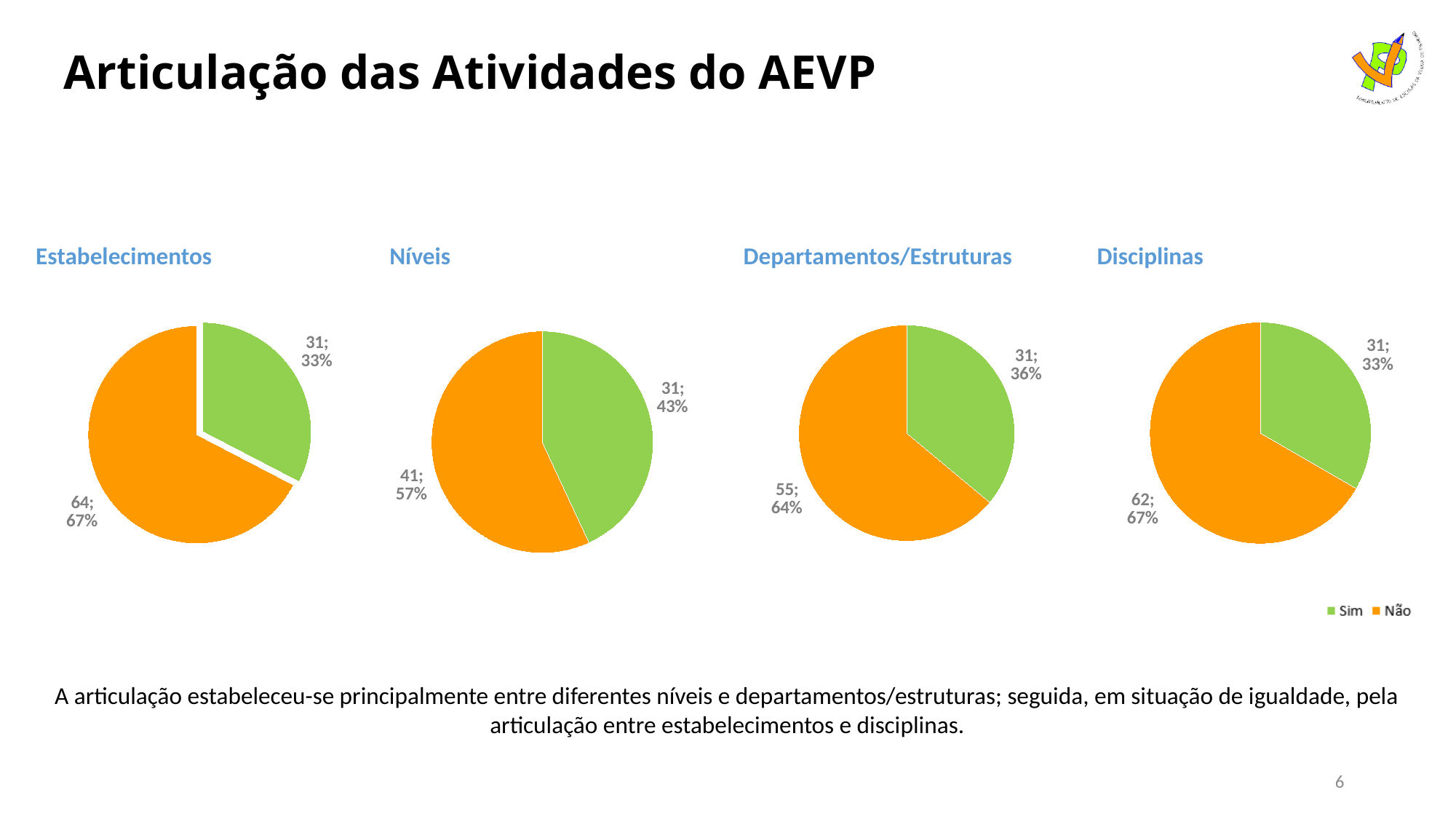
In the 'Estabelecimentos' chart, what share of the pie does 'Sim' represent? 33% In the 'Estabelecimentos' chart, what is the count for 'Não'? 64 In the 'Departamentos/Estruturas' chart, what share of the pie does 'Sim' represent? 36% In the 'Níveis' chart, what is the difference between the 'Não' count and the 'Sim' count? 10 What kind of chart is the 'Departamentos/Estruturas' chart? Pie chart How many entries does the legend list? 2 In the 'Disciplinas' chart, what is the count for 'Não'? 62 In the 'Disciplinas' chart, which slice is larger, 'Sim' or 'Não'? Não In the 'Níveis' chart, what is the count for 'Sim'? 31 In the 'Departamentos/Estruturas' chart, what is the count for 'Não'? 55 In the 'Níveis' chart, what share of the pie does 'Não' represent? 57% In the 'Estabelecimentos' chart, what is the total of the 'Sim' and 'Não' counts? 95